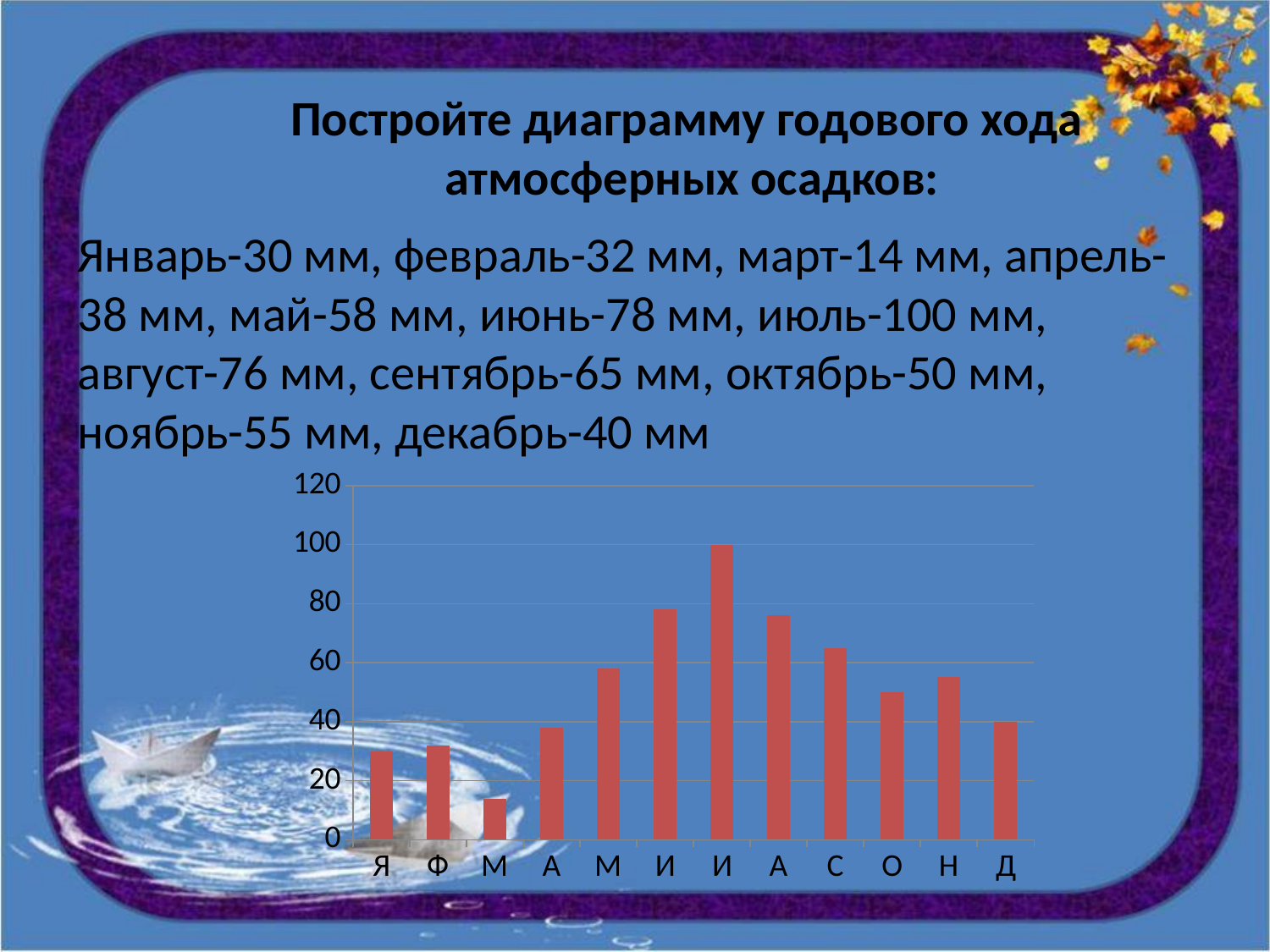
Do the bars rise or fall from January (Я) to July (the seventh bar)? rise What kind of chart is shown on the slide? bar chart How many bars (months) are plotted in the chart? 12 What is the precipitation value for March, the shortest bar? 14 мм What is the precipitation value for July, the tallest bar? 100 мм What is the precipitation value for the first bar (Я, January)? 30 мм Is the value for the sixth bar (June) greater or less than 60? greater Which month has the lowest bar in the chart? March (the third bar, М) Which is larger, the bar for September (С) or the bar for October (О)? September (С) Is the value for the last bar (Д, December) greater or less than 60? less Which month has the highest bar in the chart? July (the seventh bar, И) What is the difference between the July value and the March value? 86 мм